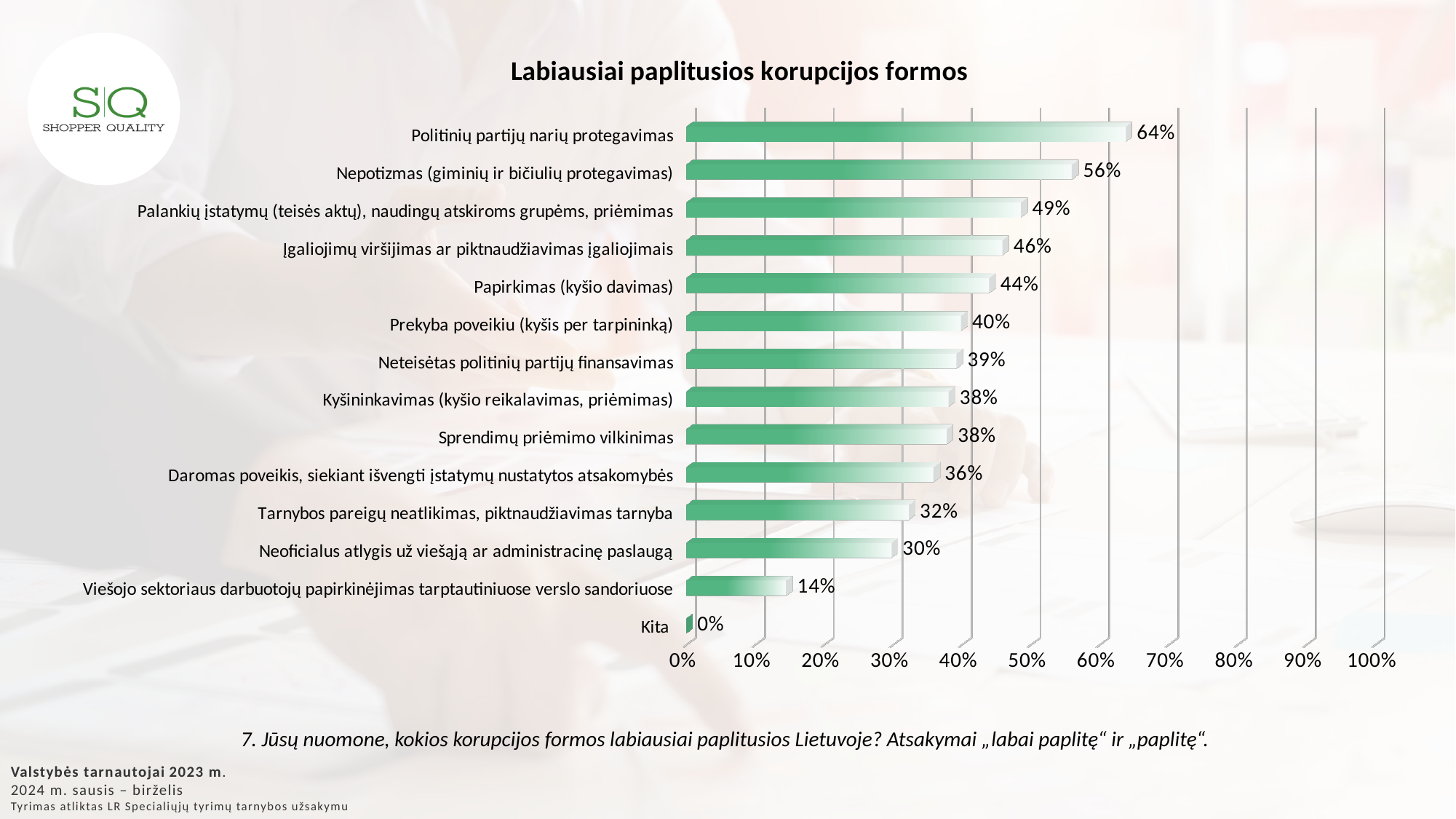
Which is larger: the value for "Įgaliojimų viršijimas ar piktnaudžiavimas įgaliojimais" or the value for "Tarnybos pareigų neatlikimas, piktnaudžiavimas tarnyba"? Įgaliojimų viršijimas ar piktnaudžiavimas įgaliojimais What is the value for "Papirkimas (kyšio davimas)"? 44% Is the value for "Palankių įstatymų (teisės aktų), naudingų atskiroms grupėms, priėmimas" greater or less than 40%? greater Which category has the lowest value? Kita What kind of chart is shown on the slide? bar chart Which category has the highest value? Politinių partijų narių protegavimas What is the value for "Viešojo sektoriaus darbuotojų papirkinėjimas tarptautiniuose verslo sandoriuose"? 14% What is the value for "Neoficialus atlygis už viešąją ar administracinę paslaugą"? 30% How many categories are shown in the chart? 14 What is the title of the chart? Labiausiai paplitusios korupcijos formos What is the difference between the values for "Nepotizmas (giminių ir bičiulių protegavimas)" and "Prekyba poveikiu (kyšis per tarpininką)"? 16% What is the value for "Politinių partijų narių protegavimas"? 64%